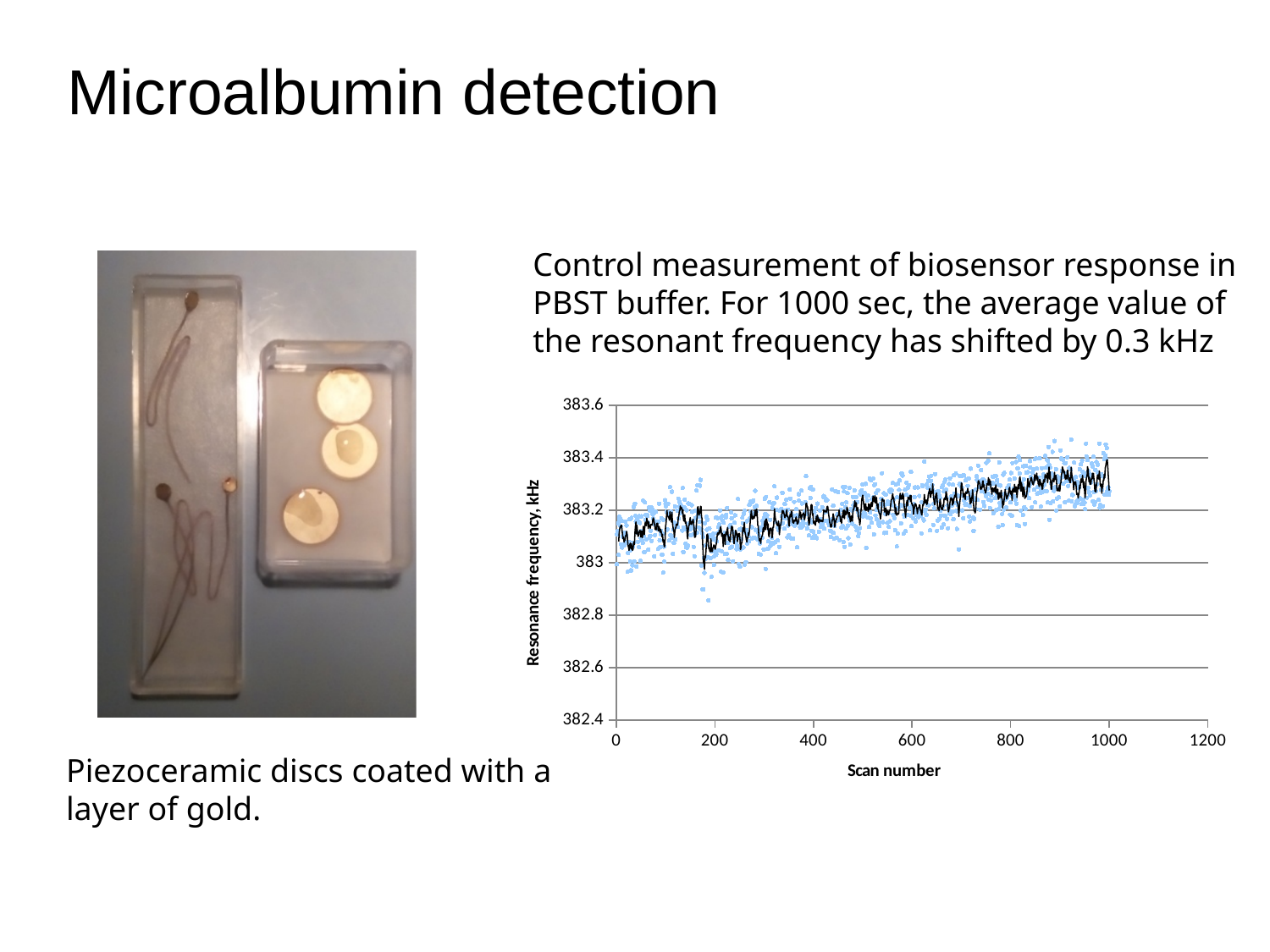
Is the resonance frequency near scan number 1000 greater or less than 383.2? greater Which is larger, the resonance frequency near scan number 1000 or near scan number 100? near scan number 1000 What is the label of the y axis of the chart? Resonance frequency, kHz Is the resonance frequency near scan number 400 greater or less than 382.8? greater Is the resonance frequency near scan number 600 greater or less than 383? greater What kind of chart is shown on the slide? scatter chart with a line What is the label of the x axis of the chart? Scan number Do the resonance frequency values rise or fall as the scan number increases? rise